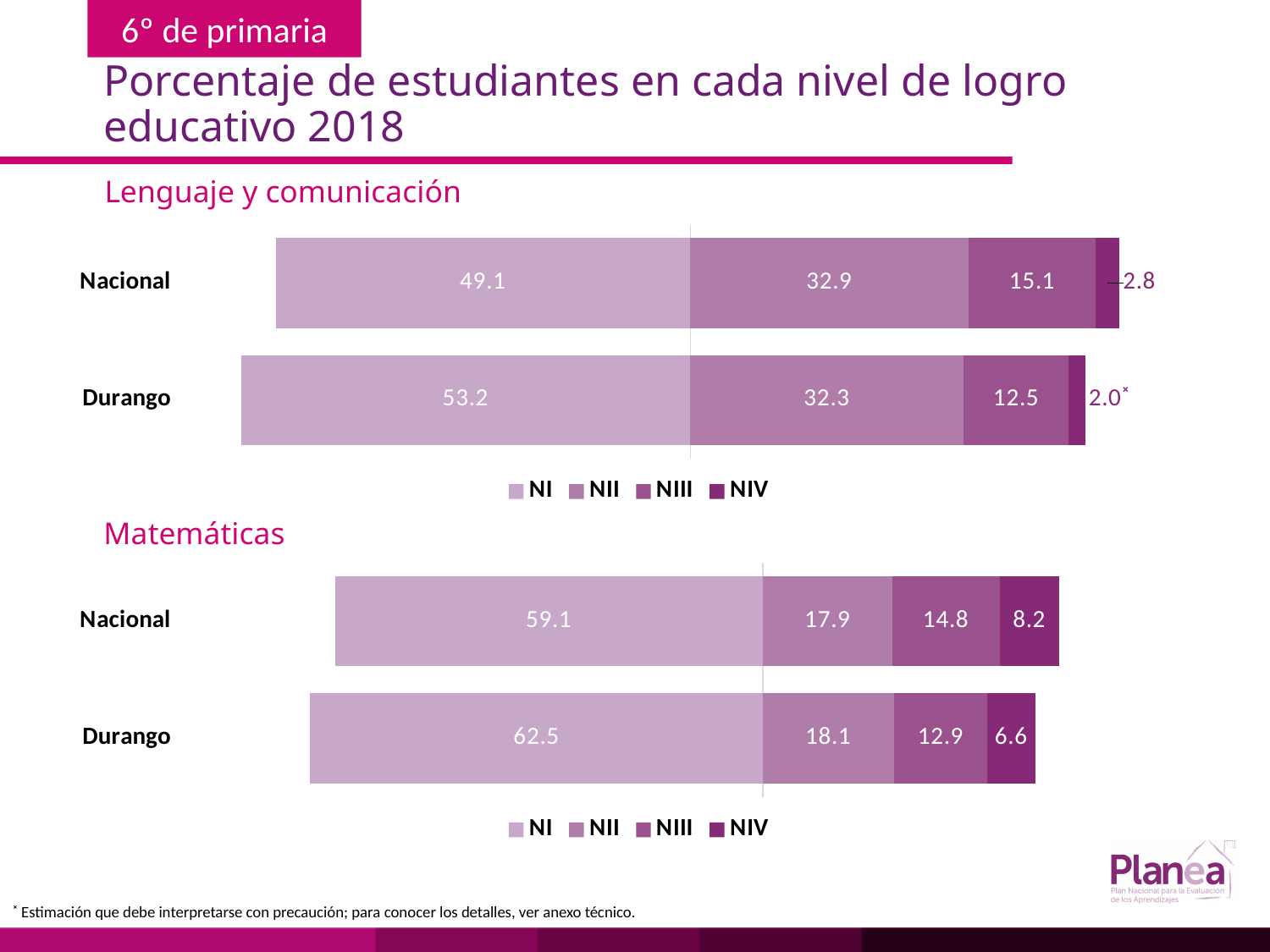
In the Lenguaje y comunicación chart, which is larger, the NIII value for Nacional or for Durango? Nacional In the Lenguaje y comunicación chart, which level has the lowest value for Nacional? NIV In the Matemáticas chart, what is the NIV value for Durango? 6.6 In the Lenguaje y comunicación chart, what is the total of the Durango bar? 100.0 In the Matemáticas chart, what is the NII value for Nacional? 17.9 In the Matemáticas chart, which level has the highest value for Durango? NI What kind of chart is the Matemáticas chart? Stacked bar chart How many categories are shown in the Lenguaje y comunicación chart? 2 How many series does the legend of the Matemáticas chart list? 4 In the Matemáticas chart, what is the difference between the NI values for Durango and Nacional? 3.4 In the Lenguaje y comunicación chart, what is the NIII value for Nacional? 15.1 In the Lenguaje y comunicación chart, what is the NI value for Durango? 53.2